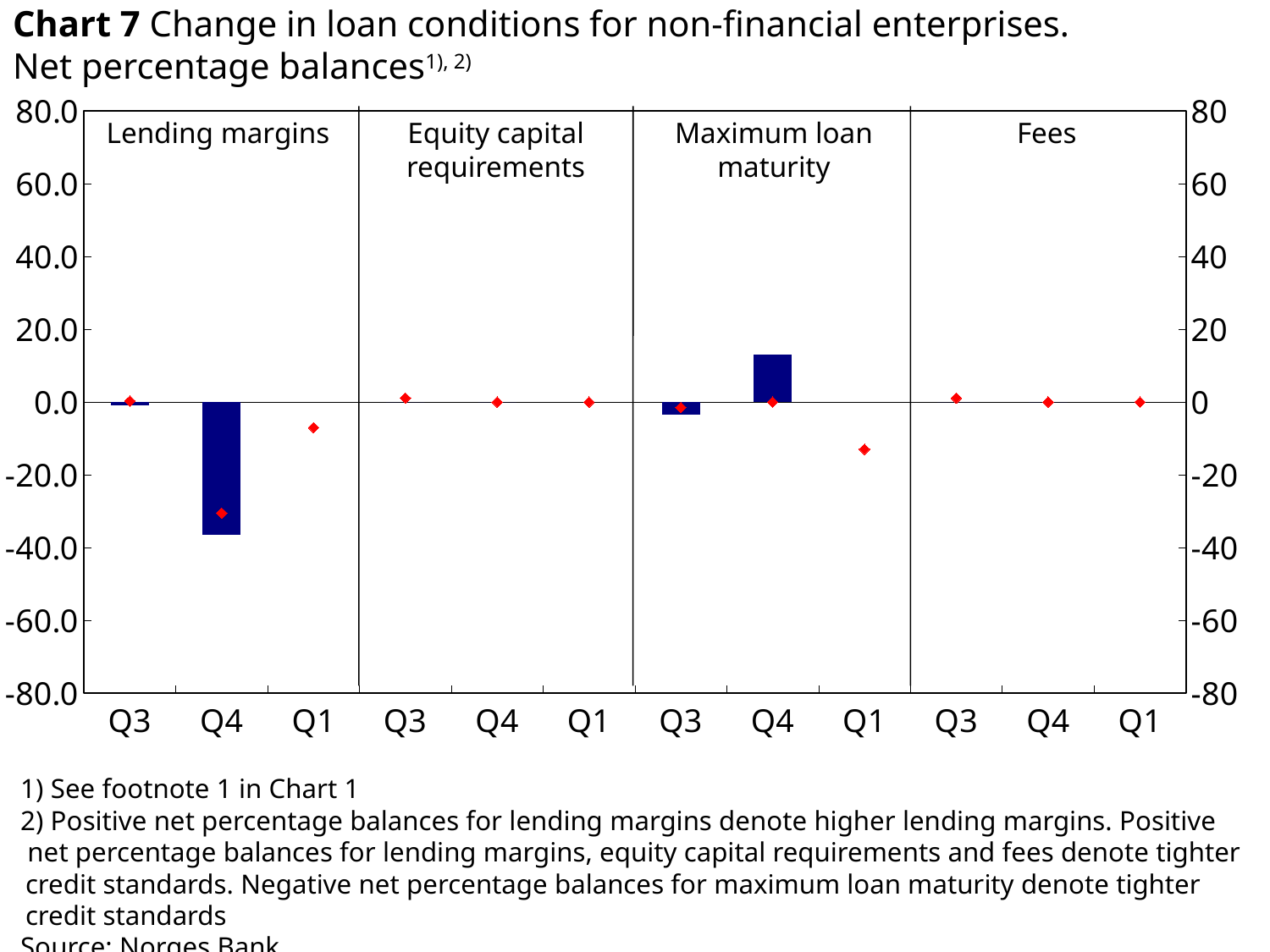
Is the bar for Q4 under Lending margins greater or less than -20? less What are the minimum and maximum values shown on the vertical axis? -80.0 and 80.0 What is the title of the chart? Chart 7 Change in loan conditions for non-financial enterprises. Net percentage balances Is the bar for Q4 under Maximum loan maturity greater or less than 20? less Which bar on the chart is the lowest? Q4 under Lending margins How many loan condition panels are shown on the chart? 4 How many quarters are shown in each panel of the chart? 3 What kind of chart is shown on the slide? bar chart Which is larger, the Q4 bar under Lending margins or the Q4 bar under Maximum loan maturity? Q4 under Maximum loan maturity Which bar on the chart is the highest? Q4 under Maximum loan maturity Is the red marker for Q1 under Maximum loan maturity greater or less than 0? less